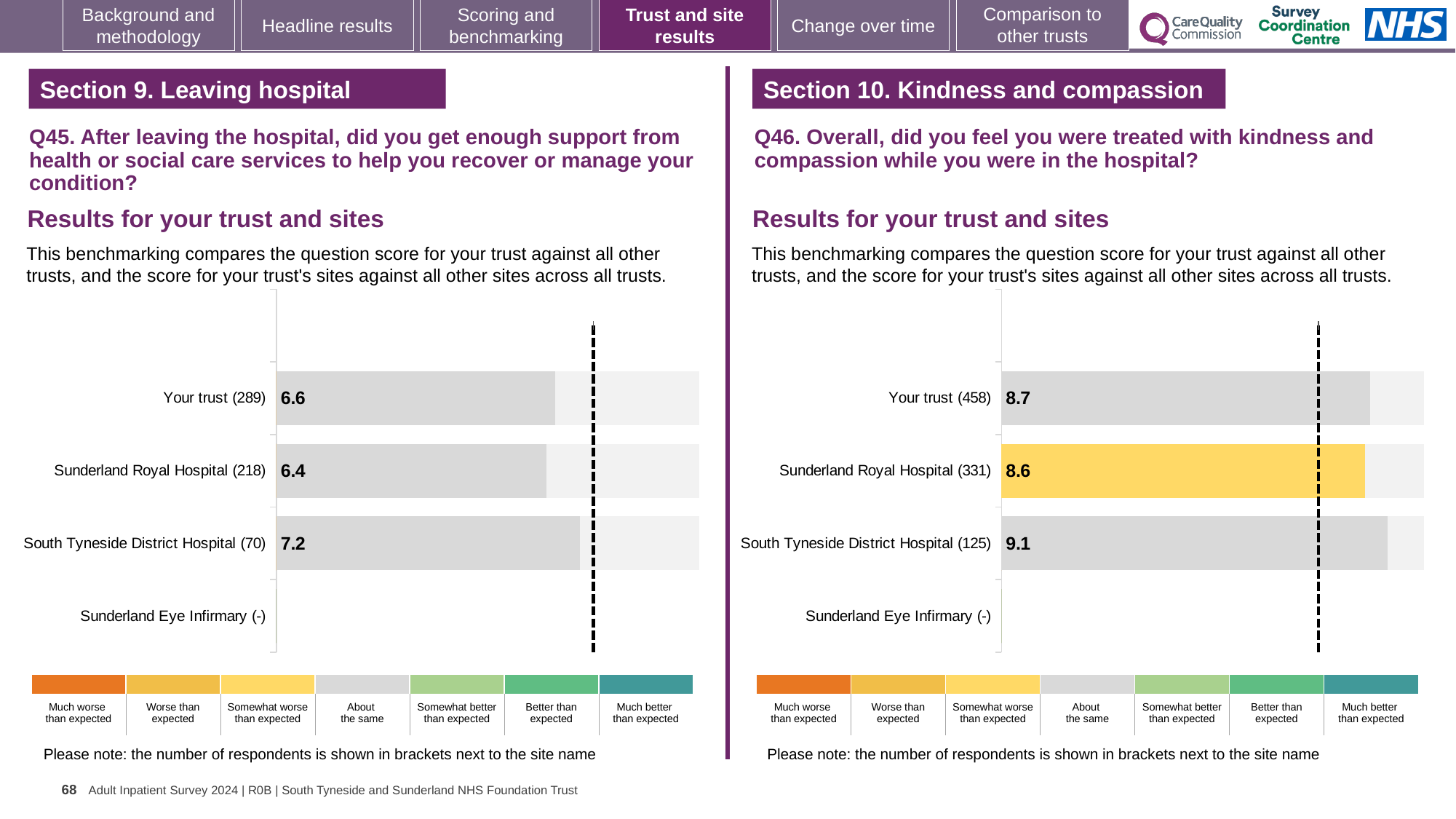
On the Q45 chart (left), what is the difference between the scores for South Tyneside District Hospital and Sunderland Royal Hospital? 0.8 On the Q45 chart (left), what is the score for Your trust? 6.6 On the Q46 chart (right), which site's bar is coloured yellow? Sunderland Royal Hospital On the Q46 chart (right), what is the score for Sunderland Royal Hospital? 8.6 On the Q46 chart (right), what is the score for Your trust? 8.7 On the Q46 chart (right), what is the difference between the scores for South Tyneside District Hospital and Your trust? 0.4 On the Q46 chart (right), which has a higher score: Your trust or South Tyneside District Hospital? South Tyneside District Hospital On the Q45 chart (left), what is the score for South Tyneside District Hospital? 7.2 On the Q46 chart (right), which site has the lowest printed score? Sunderland Royal Hospital On the Q45 chart (left), which site has the highest score? South Tyneside District Hospital What type of chart is used on the Q45 chart (left)? Bar chart How many respondents are shown in brackets for Your trust on the Q46 chart (right)? 458